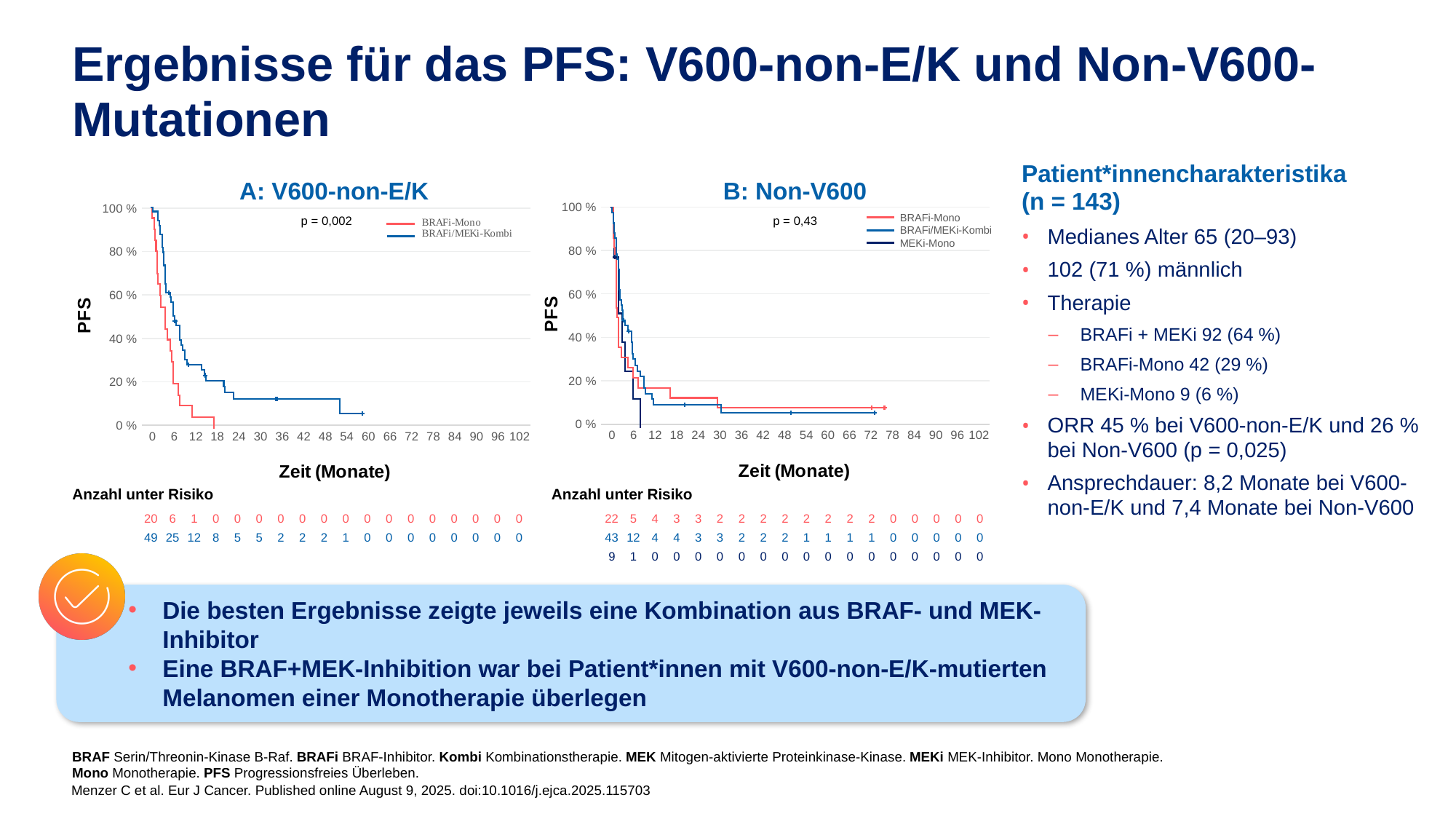
In chart A: V600-non-E/K, what p-value is shown? p = 0,002 In chart A: V600-non-E/K, what is the difference between the number at risk at month 0 for BRAFi/MEKi-Kombi and for BRAFi-Mono? 29 In chart A: V600-non-E/K, how many patients were at risk at month 0 in the BRAFi/MEKi-Kombi group? 49 In chart A: V600-non-E/K, how many series does the legend list? 2 In chart B: Non-V600, how many series does the legend list? 3 In chart B: Non-V600, how many patients were at risk at month 0 in the BRAFi-Mono group? 22 In chart B: Non-V600, how many patients were at risk at month 6 in the MEKi-Mono group? 1 In chart A: V600-non-E/K, do the PFS curves rise or fall along the x axis? Fall In chart A: V600-non-E/K, which group had more patients at risk at month 6, BRAFi-Mono or BRAFi/MEKi-Kombi? BRAFi/MEKi-Kombi In chart B: Non-V600, what p-value is shown? p = 0,43 In chart A: V600-non-E/K, is the PFS value for BRAFi/MEKi-Kombi at 36 months greater or less than 20 %? less What kind of chart is shown in panel A: V600-non-E/K? Line chart (Kaplan-Meier curve)